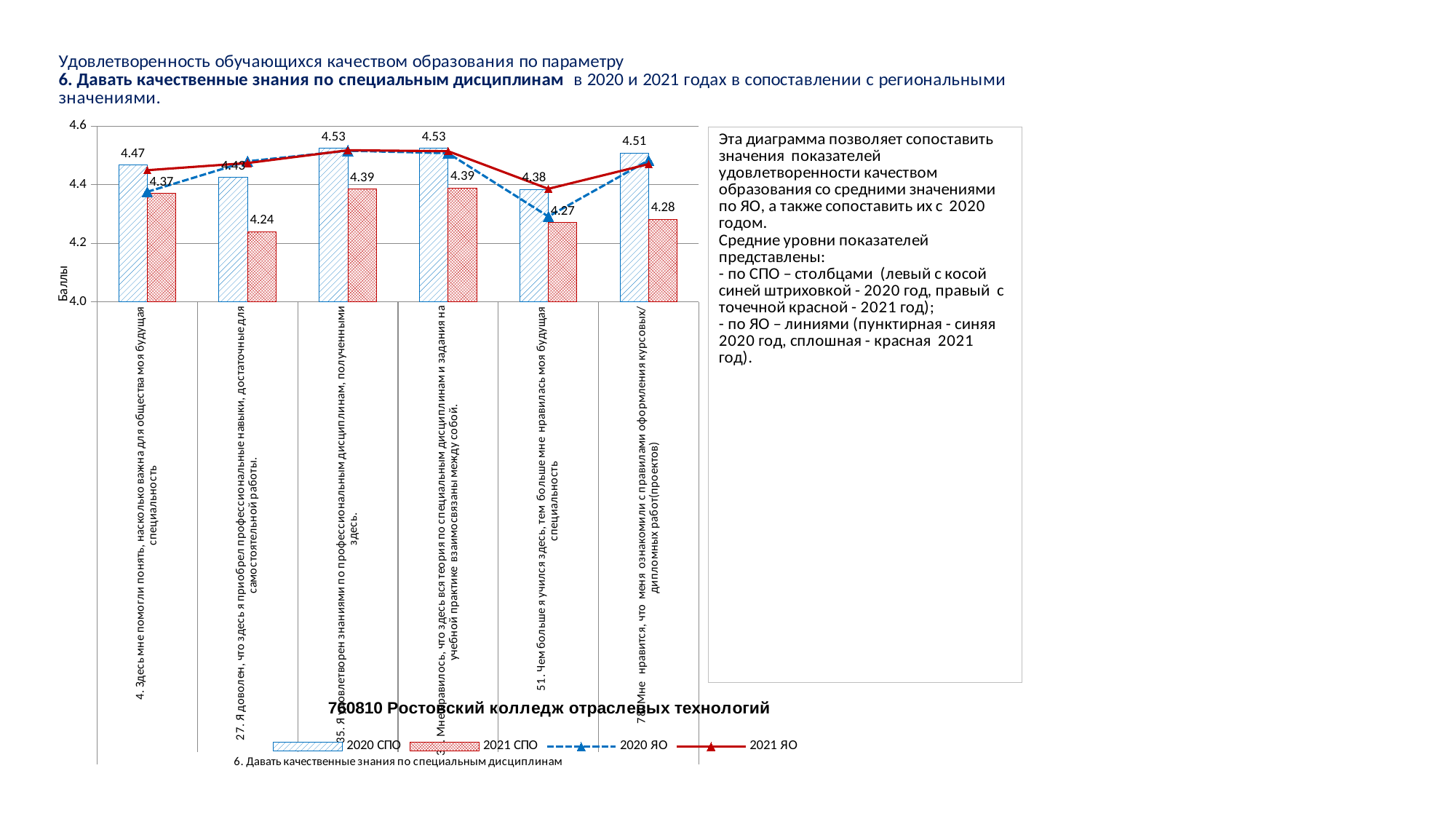
How many categories are shown on the x axis? 6 Which category has the lowest 2021 СПО value? 27. Я доволен, что здесь я приобрел профессиональные навыки, достаточные для самостоятельной работы What is the 2020 СПО value for category 51 (Чем больше я учился здесь, тем больше мне нравилась моя будущая специальность)? 4.38 How many series does the legend list? 4 Is the 2020 ЯО value for category 51 greater or less than 4.4? less What is the 2021 СПО value for category 27 (Я доволен, что здесь я приобрел профессиональные навыки, достаточные для самостоятельной работы)? 4.24 What is the 2020 СПО value for category 4 (Здесь мне помогли понять, насколько важна для общества моя будущая специальность)? 4.47 Which is larger: the 2021 СПО value for category 4 or for category 27? Category 4 What is the difference between the 2020 СПО and 2021 СПО values for category 4? 0.10 What is the title of the vertical axis? Баллы Which category has the lowest 2020 СПО value? 51. Чем больше я учился здесь, тем больше мне нравилась моя будущая специальность What is the difference between the 2020 СПО and 2021 СПО values for category 27? 0.19